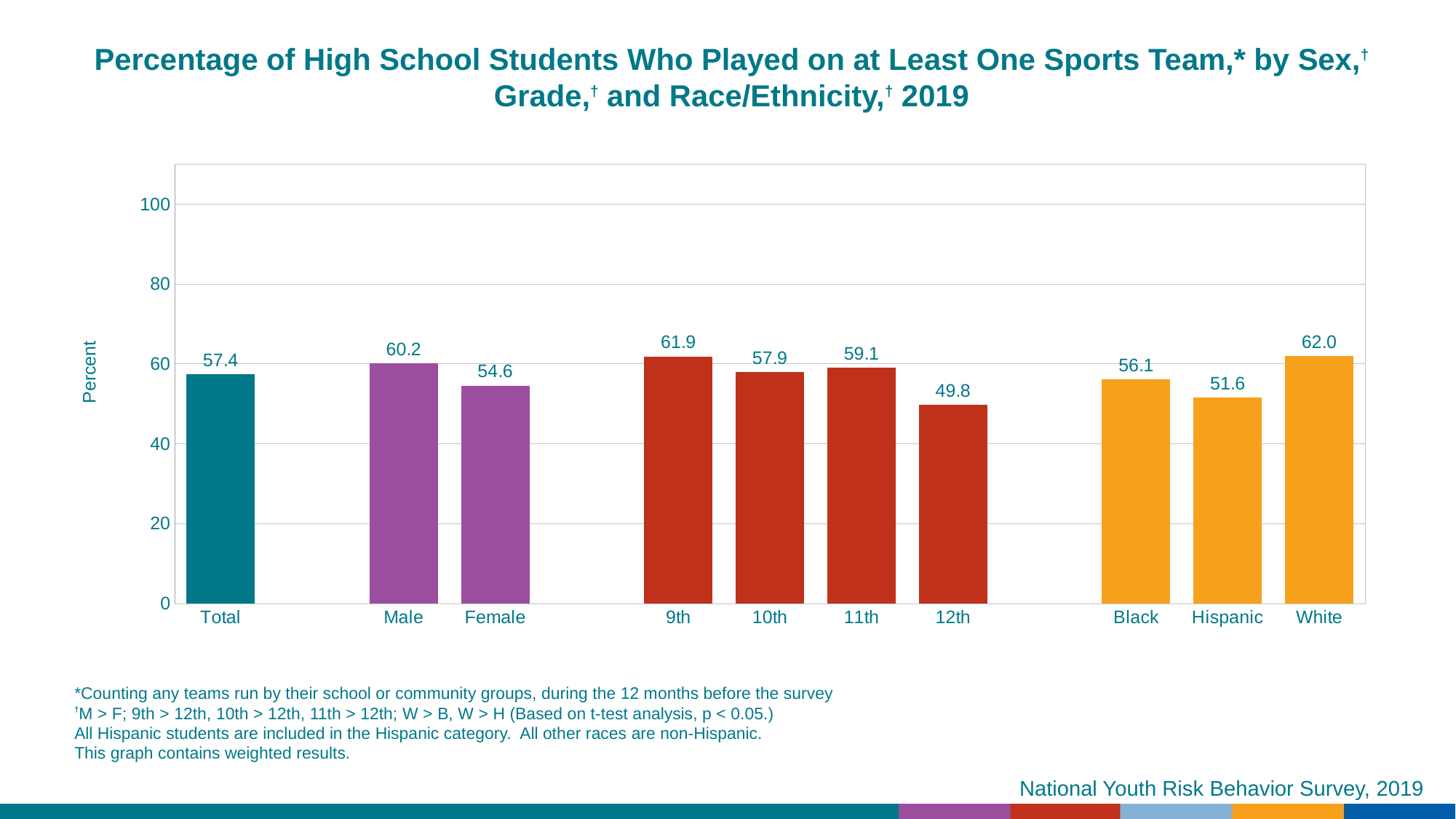
Which category has the highest value? White Which is larger, the value for Black or the value for Hispanic? Black What percentage of Female students played on at least one sports team? 54.6 What is the difference between the 9th grade and 12th grade values? 12.1 How many bars are shown in the chart? 10 What is the difference between the Male and Female values? 5.6 What is the label of the y axis? Percent What is the value for 12th grade? 49.8 Which category has the lowest value? 12th What kind of chart is shown on the slide? Bar chart What is the value for Hispanic students? 51.6 What is the value for Total? 57.4